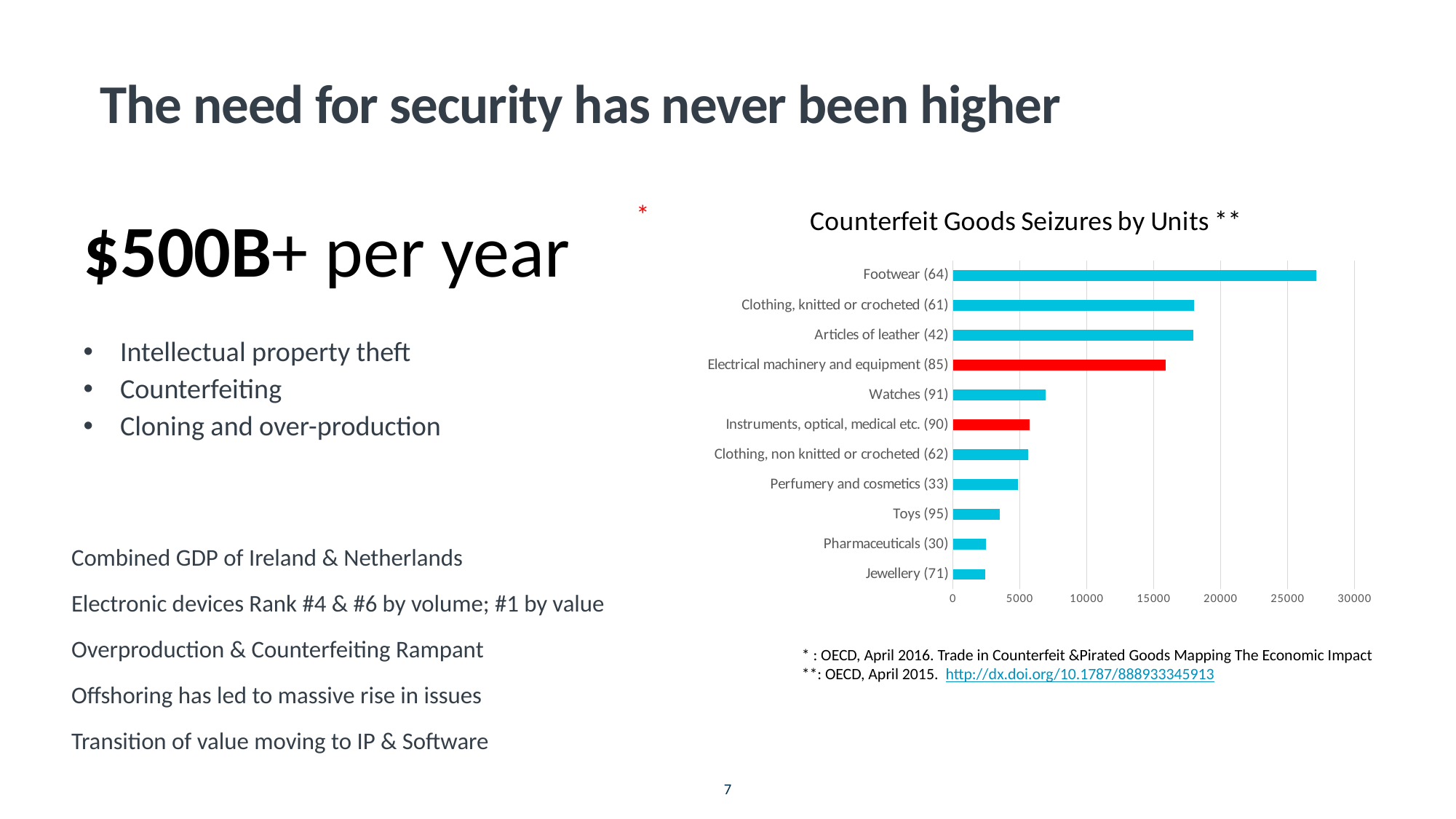
Which has a larger value, Footwear (64) or Watches (91)? Footwear (64) What is the title of the chart on the slide? Counterfeit Goods Seizures by Units ** Is the value for Watches (91) greater or less than 5000? greater Is the value for Footwear (64) greater or less than 25000? greater Is the value for Pharmaceuticals (30) greater or less than 5000? less Which category has the highest value in the Counterfeit Goods Seizures by Units chart? Footwear (64) Which two categories are shown with red bars in the chart? Electrical machinery and equipment (85) and Instruments, optical, medical etc. (90) How many categories are plotted in the Counterfeit Goods Seizures by Units chart? 11 Which has a larger value, Electrical machinery and equipment (85) or Toys (95)? Electrical machinery and equipment (85) What kind of chart is shown on the slide? bar chart